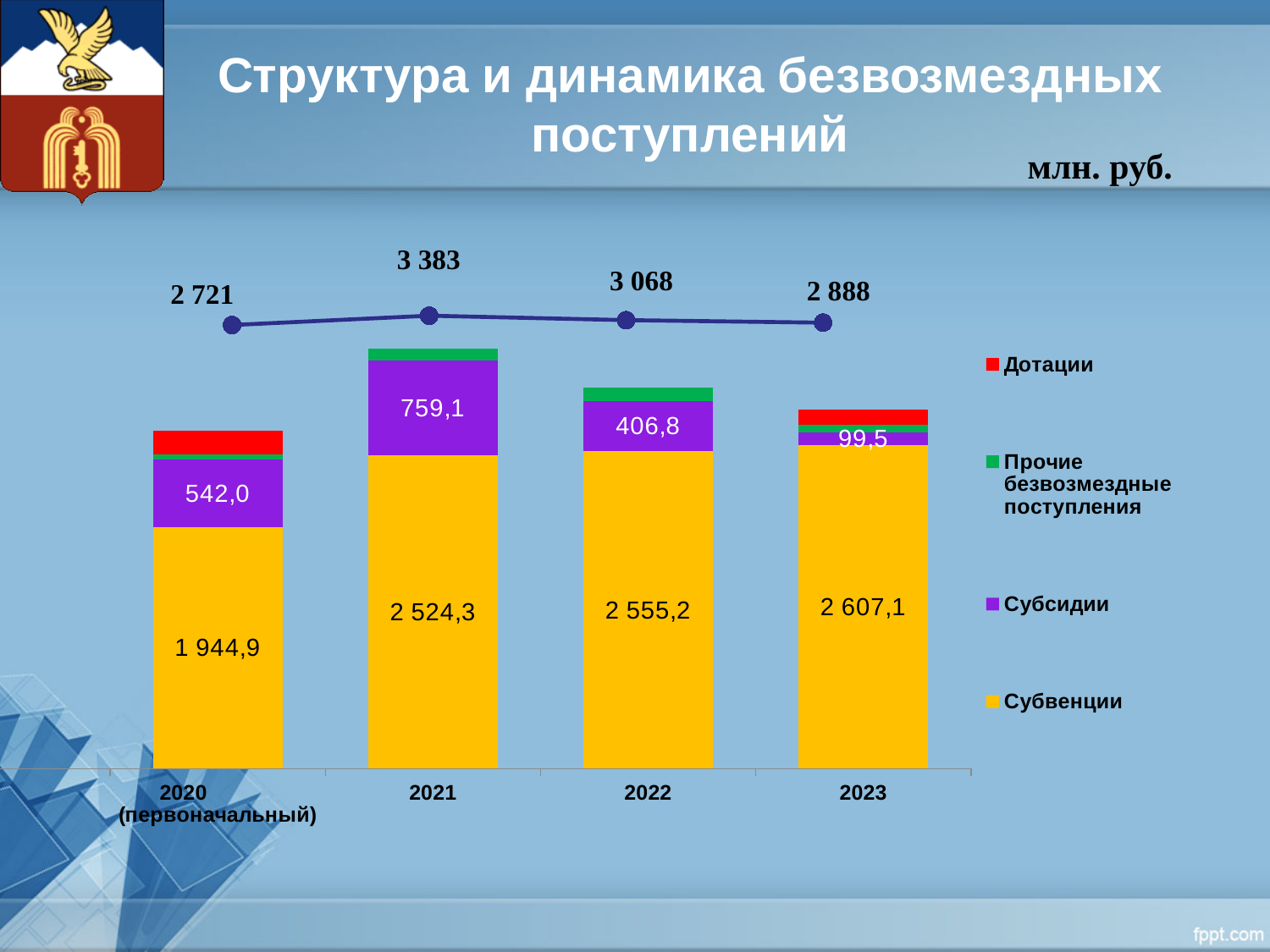
In which year is Субвенции lowest? 2020 (первоначальный) In which year is Субсидии highest? 2021 Which is larger: Субсидии in 2020 (первоначальный) or Субсидии in 2022? 2020 (первоначальный) What is the difference between Субвенции in 2023 and in 2020 (первоначальный)? 662,2 What kind of chart is shown on the slide? Stacked bar chart with a line What is the value of Субсидии for 2023? 99,5 How many years are shown on the x axis? 4 What value does the line show above the 2022 bar? 3 068 What is the value of Субвенции for 2021? 2 524,3 How many series does the legend list? 4 Do the Субвенции values rise or fall from 2020 to 2023? Rise What is the difference between Субсидии in 2021 and in 2022? 352,3